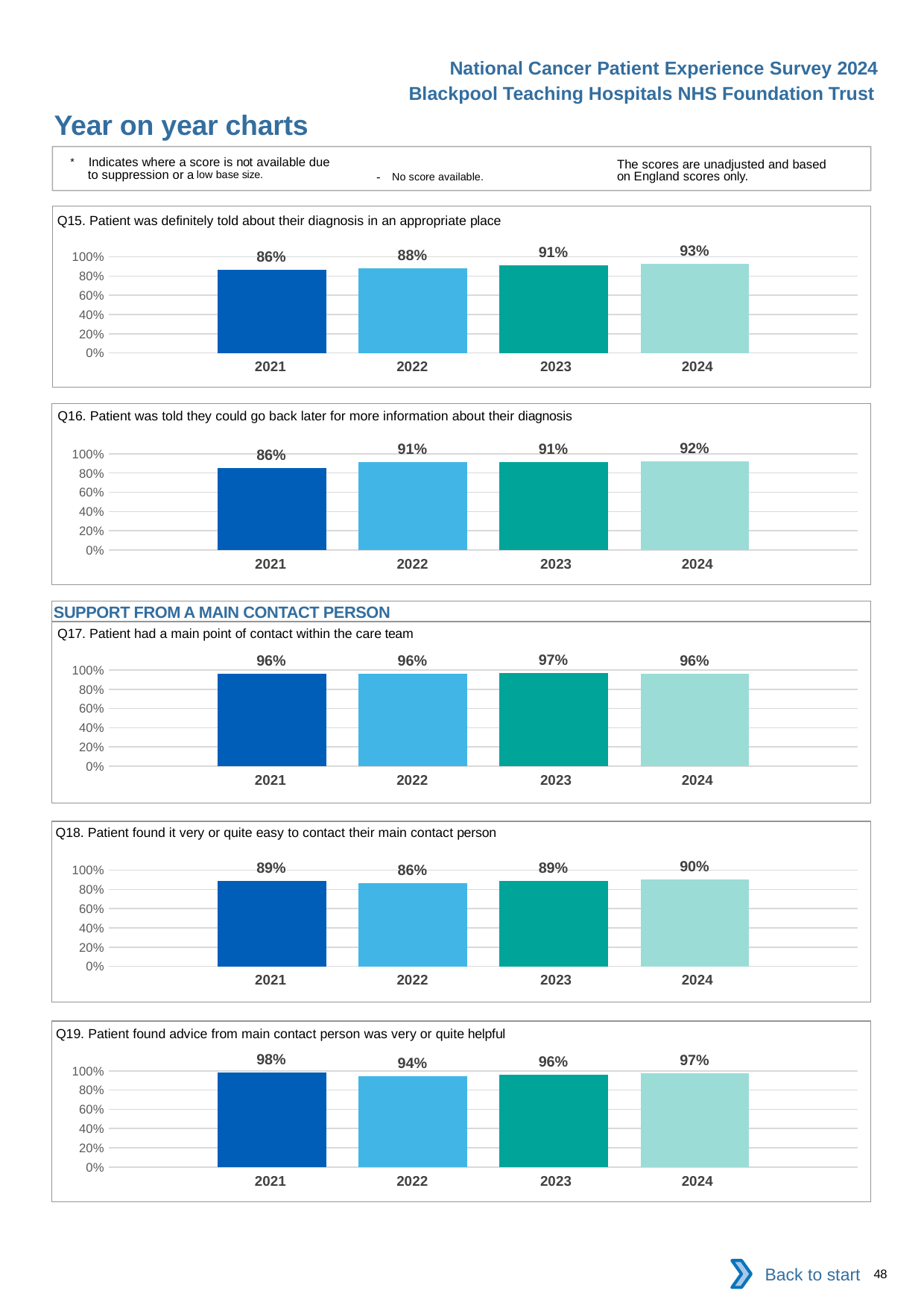
In the Q19 chart, what is the difference between the 2021 value and the 2022 value? 4% In the Q18 chart, what is the value for 2024? 90% In the Q19 chart (patient found advice from main contact person was very or quite helpful), which year has the highest value? 2021 In the Q19 chart, which is larger, the value for 2023 or the value for 2024? 2024 In the Q18 chart (patient found it very or quite easy to contact their main contact person), which year has the lowest value? 2022 In the Q15 chart, do the values rise or fall from 2021 to 2024? rise In the Q17 chart (patient had a main point of contact within the care team), which year has the highest value? 2023 In the Q16 chart, what is the difference between the 2024 value and the 2021 value? 6% In the Q16 chart (patient was told they could go back later for more information), what is the value for 2021? 86% What kind of chart is the Q15 chart? bar chart In the Q17 chart, how many years are plotted? 4 In the Q15 chart (patient was definitely told about their diagnosis in an appropriate place), what is the value for 2024? 93%